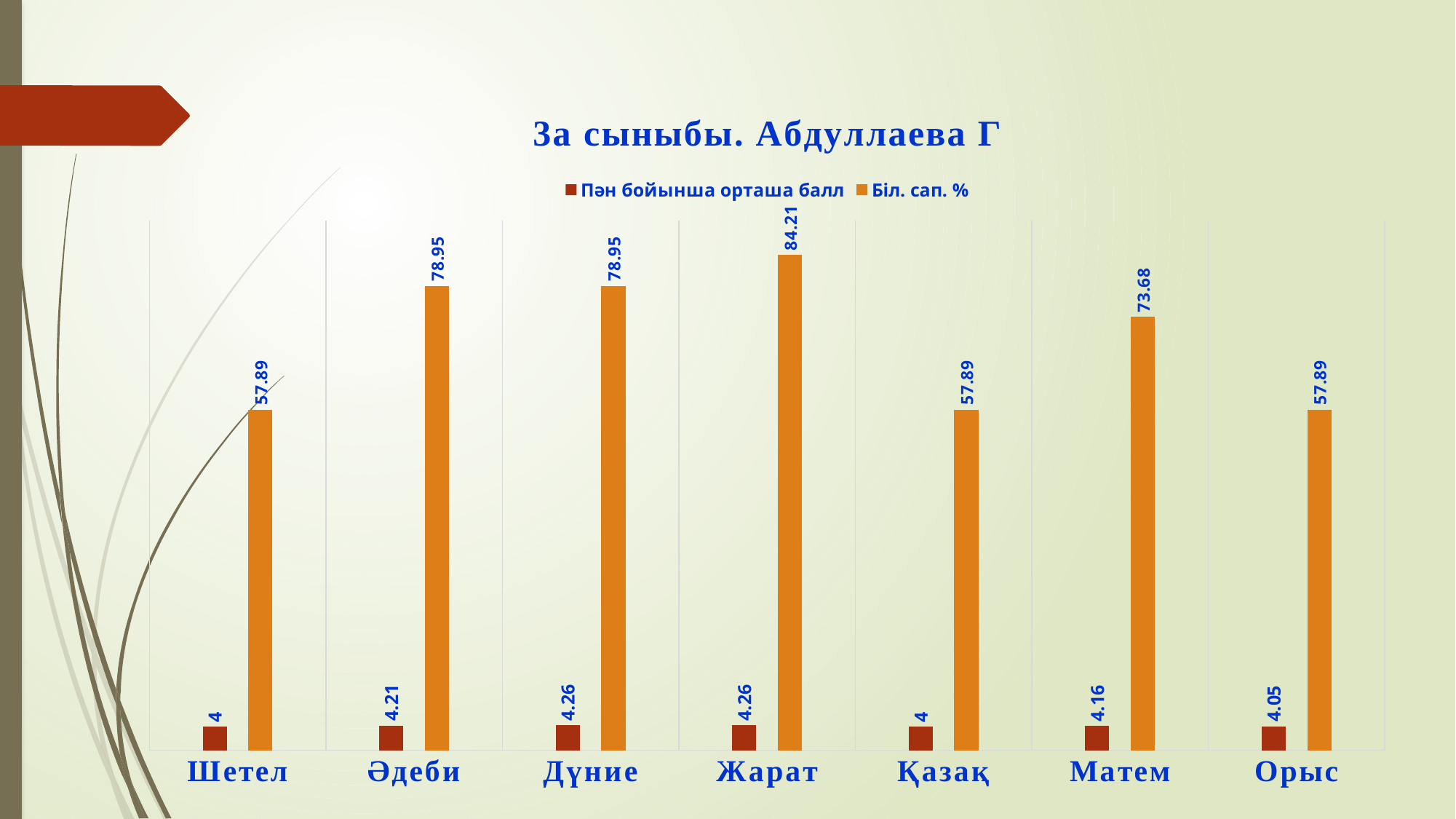
What is the value of Біл. сап. % for Жарат? 84.21 How many subject categories are shown on the x axis? 7 What is the title of the chart? 3а сыныбы. Абдуллаева Г What is the value of Пән бойынша орташа балл for Матем? 4.16 What is the value of Біл. сап. % for Матем? 73.68 What kind of chart is shown on the slide? bar chart Which category has the lowest Пән бойынша орташа балл value? Шетел and Қазақ (both 4) Which has a larger Біл. сап. % value, Әдеби or Шетел? Әдеби What is the difference between the Біл. сап. % values for Жарат and Матем? 10.53 Which category has the highest Біл. сап. % value? Жарат How many series does the legend list? 2 What is the difference between the Пән бойынша орташа балл values for Дүние and Шетел? 0.26